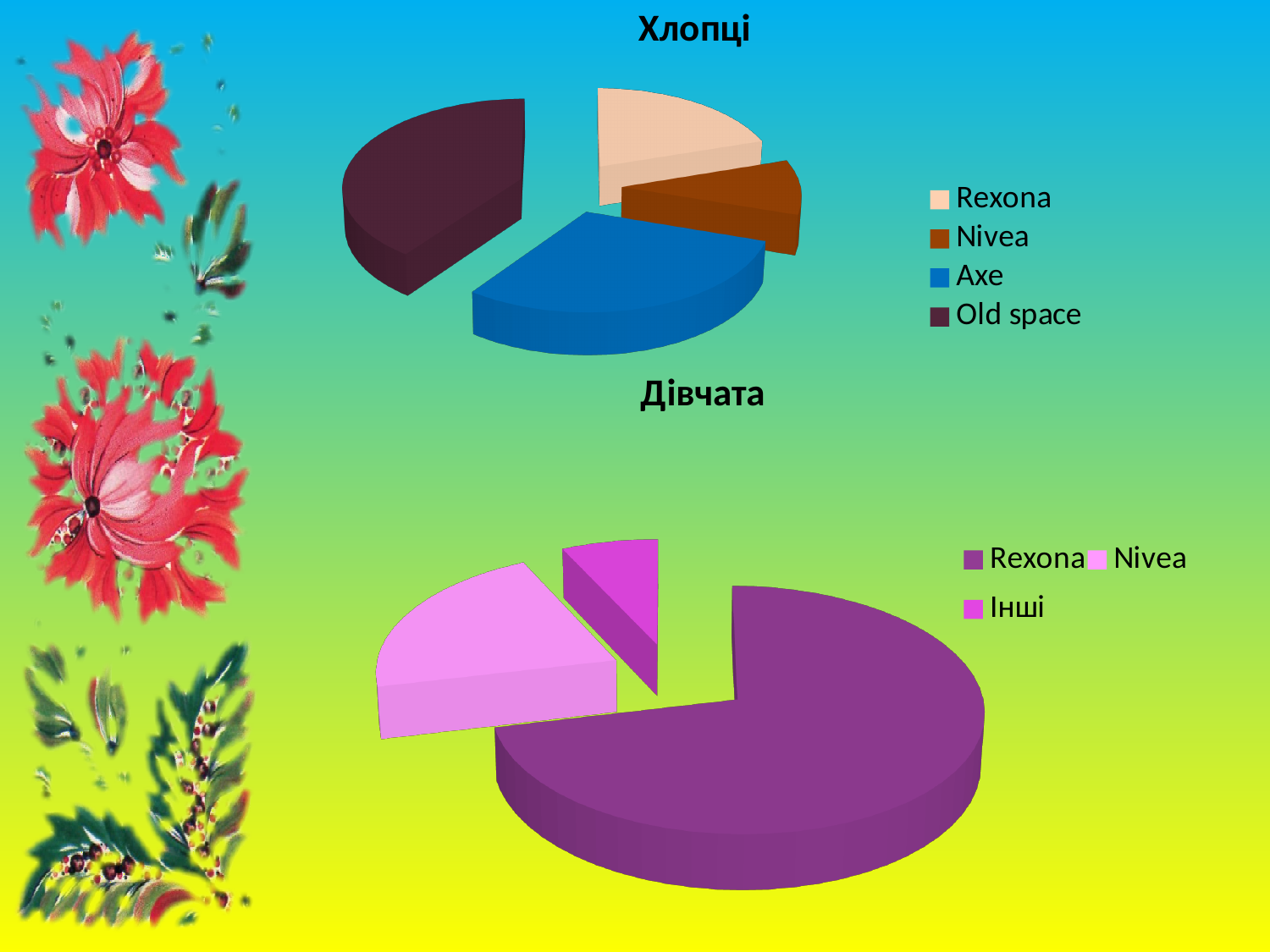
In the chart titled "Дівчата", which slice is larger, Nivea or Інші? Nivea In the chart titled "Дівчата", how many slices does the pie have? 3 In the chart titled "Хлопці", how many slices does the pie have? 4 In the chart titled "Дівчата", which category has the smallest slice? Інші What is the title of the lower chart on the slide? Дівчата In the chart titled "Хлопці", which category has the largest slice? Old space In the chart titled "Дівчата", which category has the largest slice? Rexona In the chart titled "Хлопці", which category has the smallest slice? Nivea What kind of chart is the chart titled "Дівчата"? pie chart In the chart titled "Хлопці", how many entries does the legend list? 4 In the chart titled "Хлопці", which slice is larger, Axe or Nivea? Axe What kind of chart is the chart titled "Хлопці"? pie chart